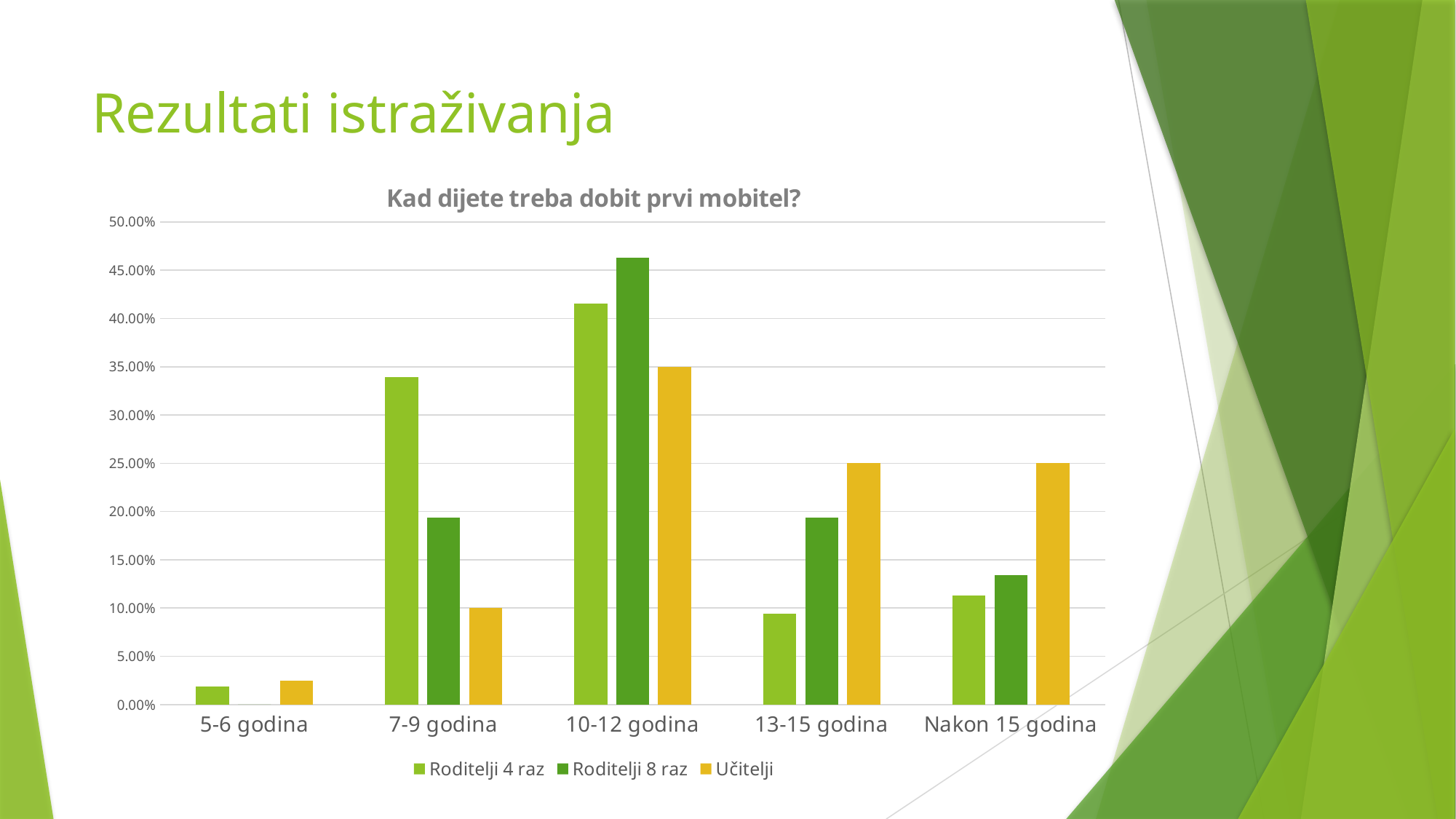
At 7-9 godina, which series has the larger value: Roditelji 4 raz or Učitelji? Roditelji 4 raz Which age category has the lowest value for Roditelji 4 raz? 5-6 godina At 13-15 godina, which series has the larger value: Roditelji 8 raz or Učitelji? Učitelji What is the title of the chart? Kad dijete treba dobit prvi mobitel? How many age categories are shown on the x axis? 5 Which age category has the highest value for Učitelji? 10-12 godina Which age category has the highest value for Roditelji 8 raz? 10-12 godina How many series does the legend list? 3 What kind of chart is shown on the slide? bar chart Is the value for Roditelji 8 raz at 10-12 godina greater or less than 45.00%? greater Is the value for Roditelji 4 raz at 7-9 godina greater or less than 30.00%? greater